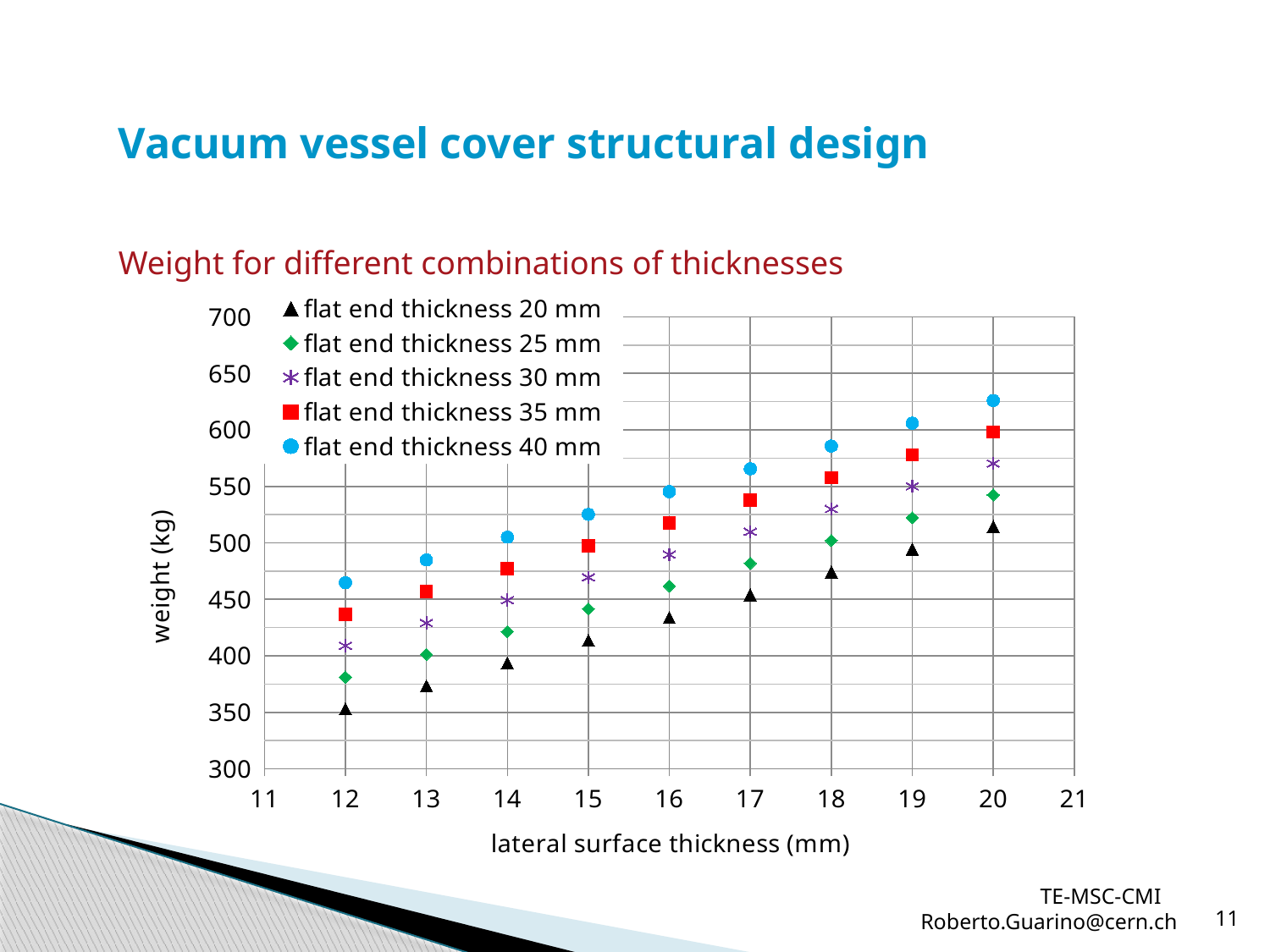
Does the weight rise or fall as lateral surface thickness increases from 12 mm to 20 mm? rises Is the weight for 'flat end thickness 30 mm' at a lateral surface thickness of 14 mm greater or less than 500? less Is the weight for 'flat end thickness 20 mm' at a lateral surface thickness of 12 mm greater or less than 400? less At a lateral surface thickness of 15 mm, which is larger: the weight for 'flat end thickness 40 mm' or for 'flat end thickness 20 mm'? flat end thickness 40 mm Is the weight for 'flat end thickness 40 mm' at a lateral surface thickness of 20 mm greater or less than 600? greater What is the label of the vertical axis? weight (kg) What kind of chart is shown on the slide? scatter chart Which series has the lowest weight at a lateral surface thickness of 12 mm? flat end thickness 20 mm How many series does the legend list? 5 How many data points are plotted for the 'flat end thickness 40 mm' series? 9 Which series has the highest weight at a lateral surface thickness of 20 mm? flat end thickness 40 mm